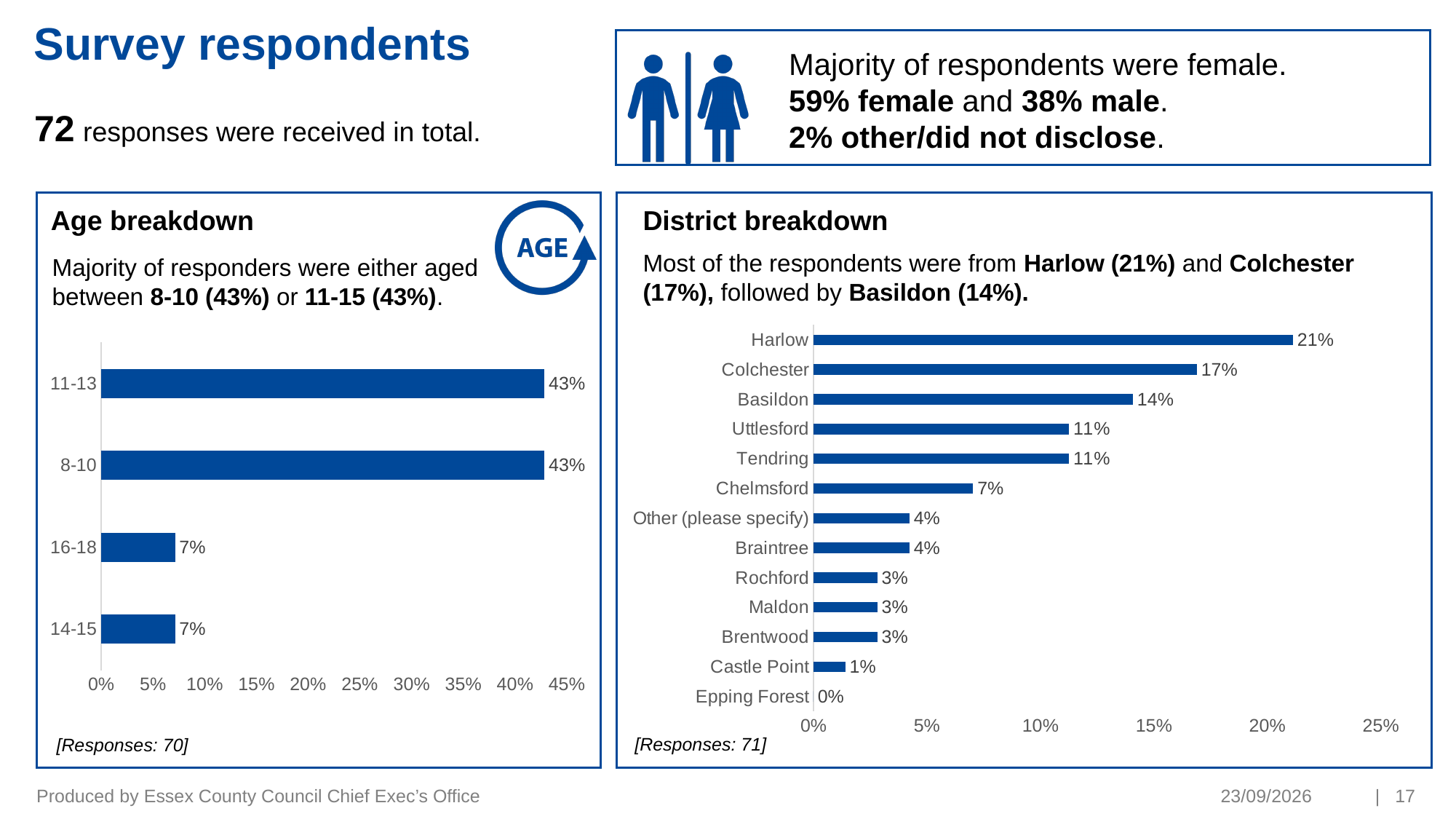
In the Age breakdown chart, what is the value for the 11-13 age group? 43% In the Age breakdown chart, what is the difference between the 8-10 and 14-15 values? 36% How many districts/categories are listed in the District breakdown chart? 13 In the District breakdown chart, which is larger, Chelmsford or Braintree? Chelmsford How many age groups are shown in the Age breakdown chart? 4 In the District breakdown chart, what is the value for Castle Point? 1% What type of chart is the Age breakdown chart? Bar chart In the Age breakdown chart, what percentage of respondents were aged 16-18? 7% In the District breakdown chart, which district has the lowest value? Epping Forest In the District breakdown chart, which district has the highest value? Harlow In the District breakdown chart, what percentage of respondents were from Uttlesford? 11% In the District breakdown chart, what is the difference between Harlow and Colchester? 4%